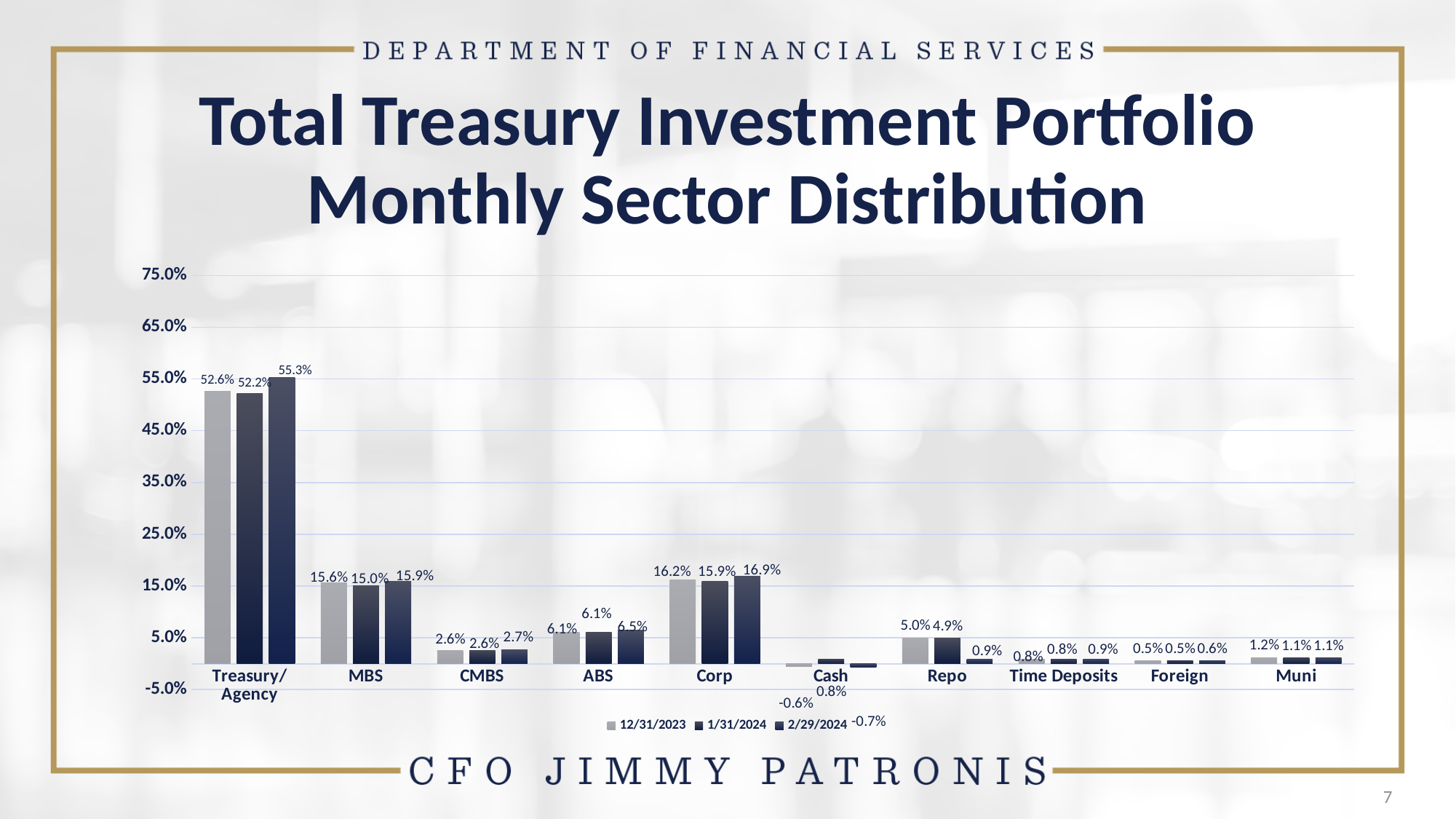
What is the difference between the Repo values for 12/31/2023 and 2/29/2024? 4.1% How many sectors are shown on the x axis? 10 What kind of chart is shown on the slide? Bar chart What is the value for Treasury/Agency in the 2/29/2024 series? 55.3% What is the value for Corp in the 12/31/2023 series? 16.2% Which sector has the lowest value in the 12/31/2023 series? Cash What is the value for Repo in the 2/29/2024 series? 0.9% Which is larger in the 2/29/2024 series: Corp or MBS? Corp How many series does the legend list? 3 What is the value for Cash in the 1/31/2024 series? 0.8% Which sector has the highest value in the 2/29/2024 series? Treasury/Agency What is the difference between the Treasury/Agency values for 2/29/2024 and 1/31/2024? 3.1%